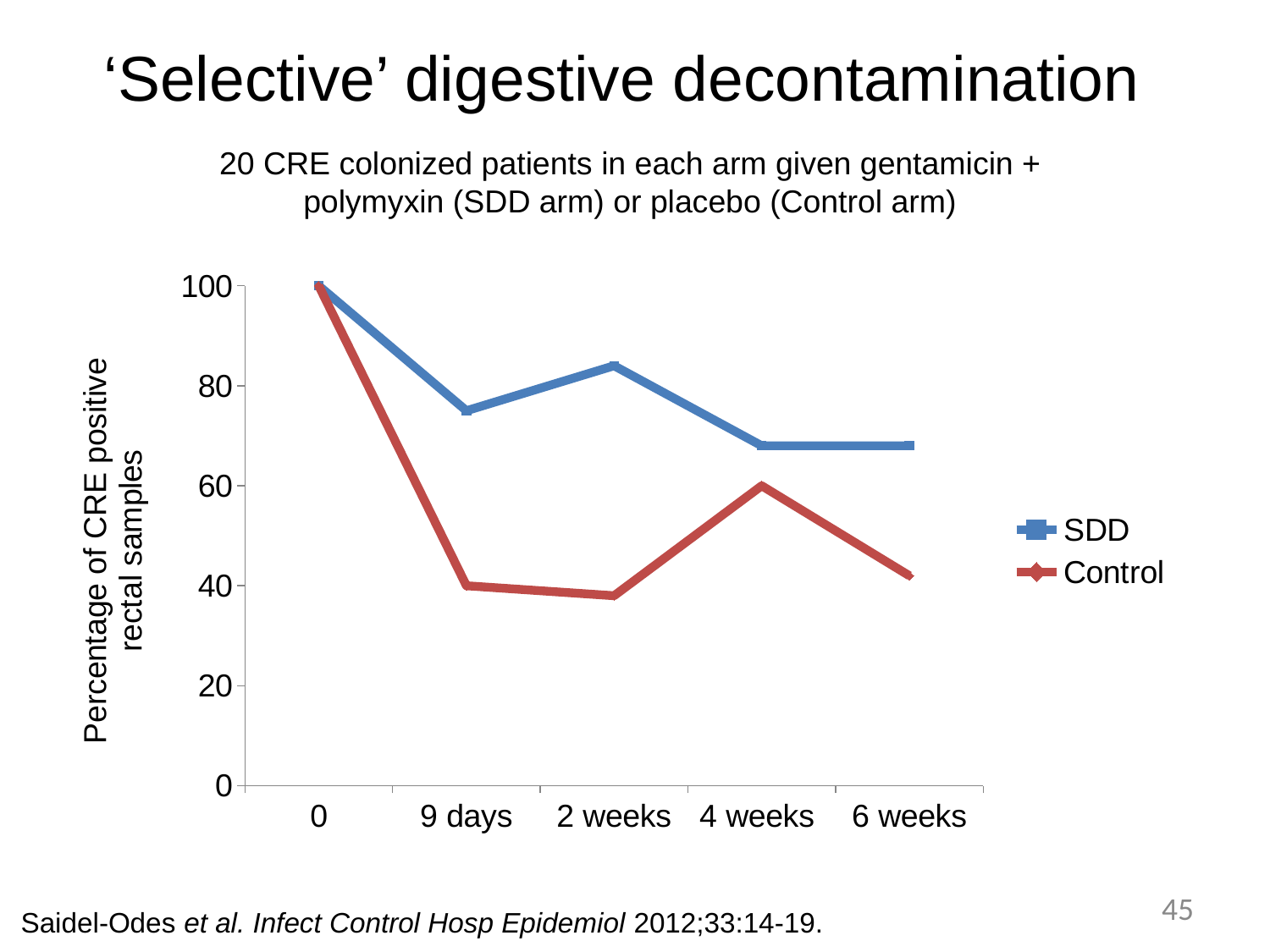
Is the value for SDD at 2 weeks greater or less than 80? greater Is the value for Control at 6 weeks greater or less than 60? less Is the value for SDD at 9 days greater or less than 80? less What kind of chart is shown on the slide? line chart Does the SDD series rise or fall between time 0 and 9 days? fall How many time points are plotted along the x axis? 5 What is the value for the SDD series at time 0? 100 How many series does the legend list? 2 What is the label on the y axis? Percentage of CRE positive rectal samples What is the value for the Control series at time 0? 100 At 6 weeks, which series has the higher value, SDD or Control? SDD